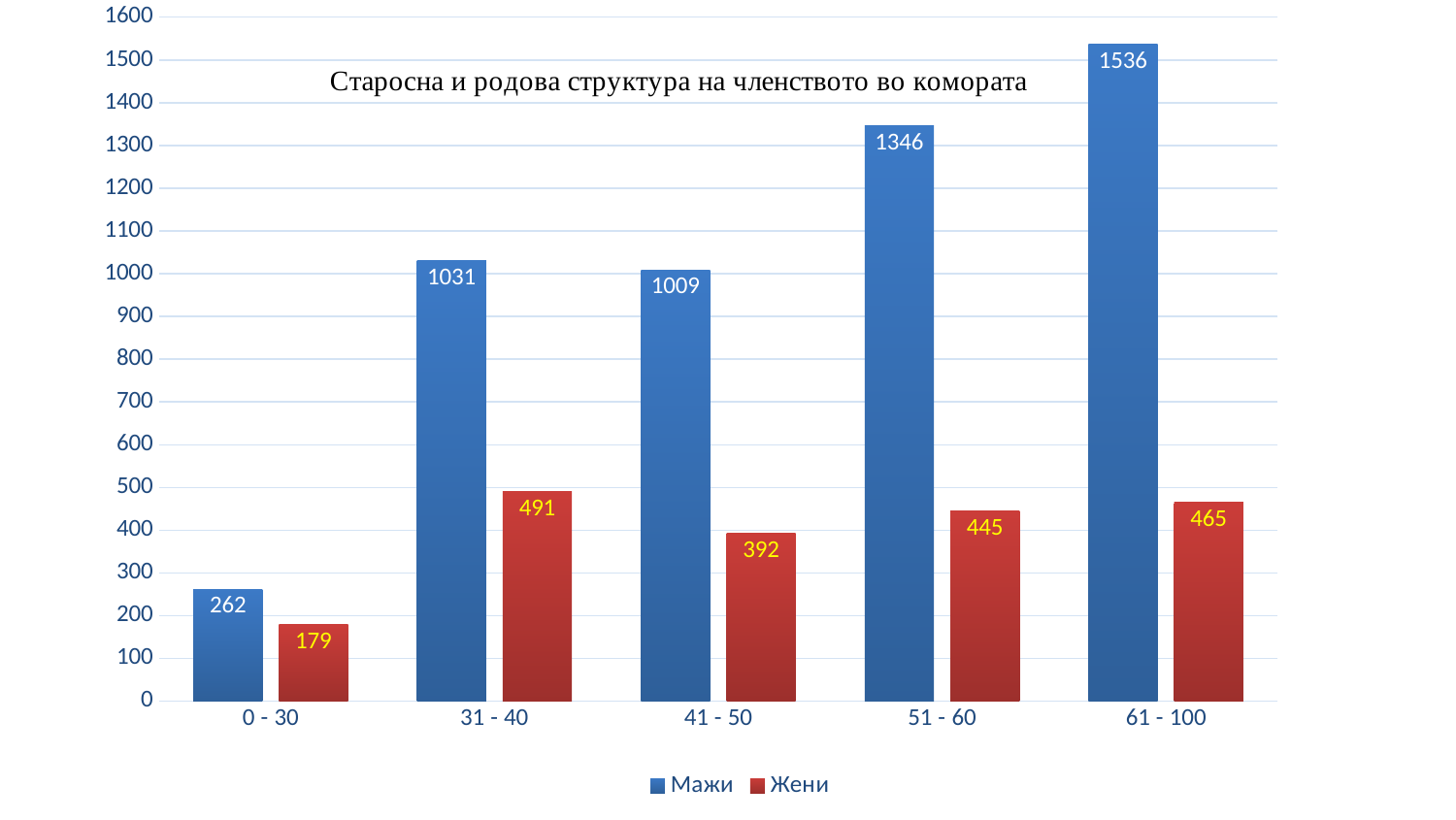
Is the value for Мажи in the 41 - 50 age group greater or less than 1000? greater What is the difference between Мажи and Жени in the 51 - 60 age group? 901 How many age groups are shown on the x axis? 5 Which age group has the highest value for Мажи? 61 - 100 Which is larger: Жени in the 41 - 50 group or Жени in the 61 - 100 group? 61 - 100 How many series does the legend list? 2 What is the value for Мажи in the 61 - 100 age group? 1536 What kind of chart is shown on the slide? Bar chart Which age group has the lowest value for Жени? 0 - 30 What is the value for Жени in the 31 - 40 age group? 491 What is the title of the chart? Старосна и родова структура на членството во комората What is the value for Жени in the 0 - 30 age group? 179